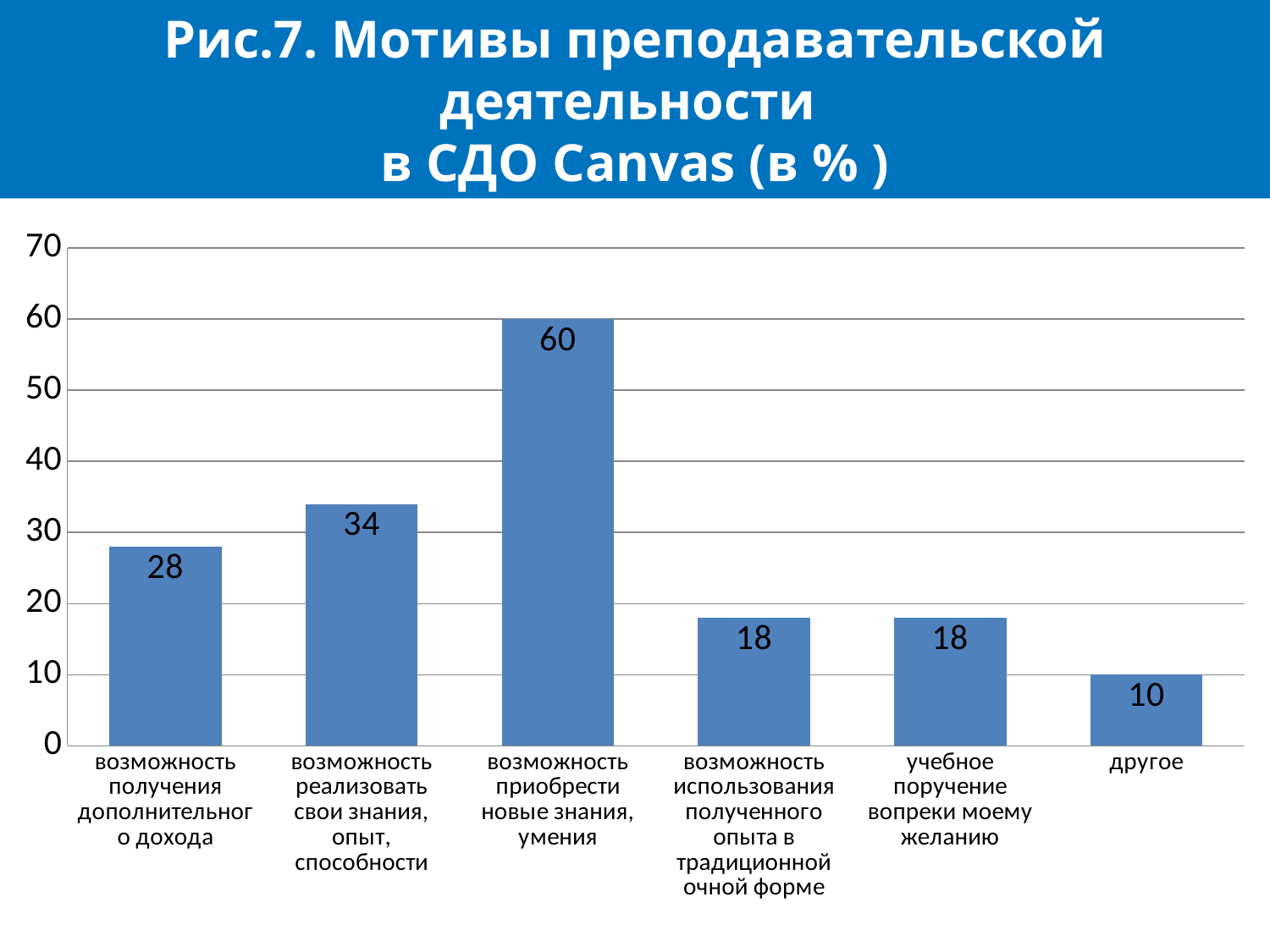
Which is larger: the value for "возможность реализовать свои знания, опыт, способности" or the value for "возможность получения дополнительного дохода"? возможность реализовать свои знания, опыт, способности Is the value for "возможность использования полученного опыта в традиционной очной форме" greater or less than 20? less Which category has the lowest value? другое What is the value for "возможность получения дополнительного дохода"? 28 What is the value for "учебное поручение вопреки моему желанию"? 18 What is the value for "возможность приобрести новые знания, умения"? 60 Which category has the highest value? возможность приобрести новые знания, умения What is the title of the chart on the slide? Рис.7. Мотивы преподавательской деятельности в СДО Canvas (в % ) What kind of chart is shown on the slide? bar chart What is the difference between the values for "возможность приобрести новые знания, умения" and "возможность реализовать свои знания, опыт, способности"? 26 What is the value for "другое"? 10 How many categories are shown on the chart? 6